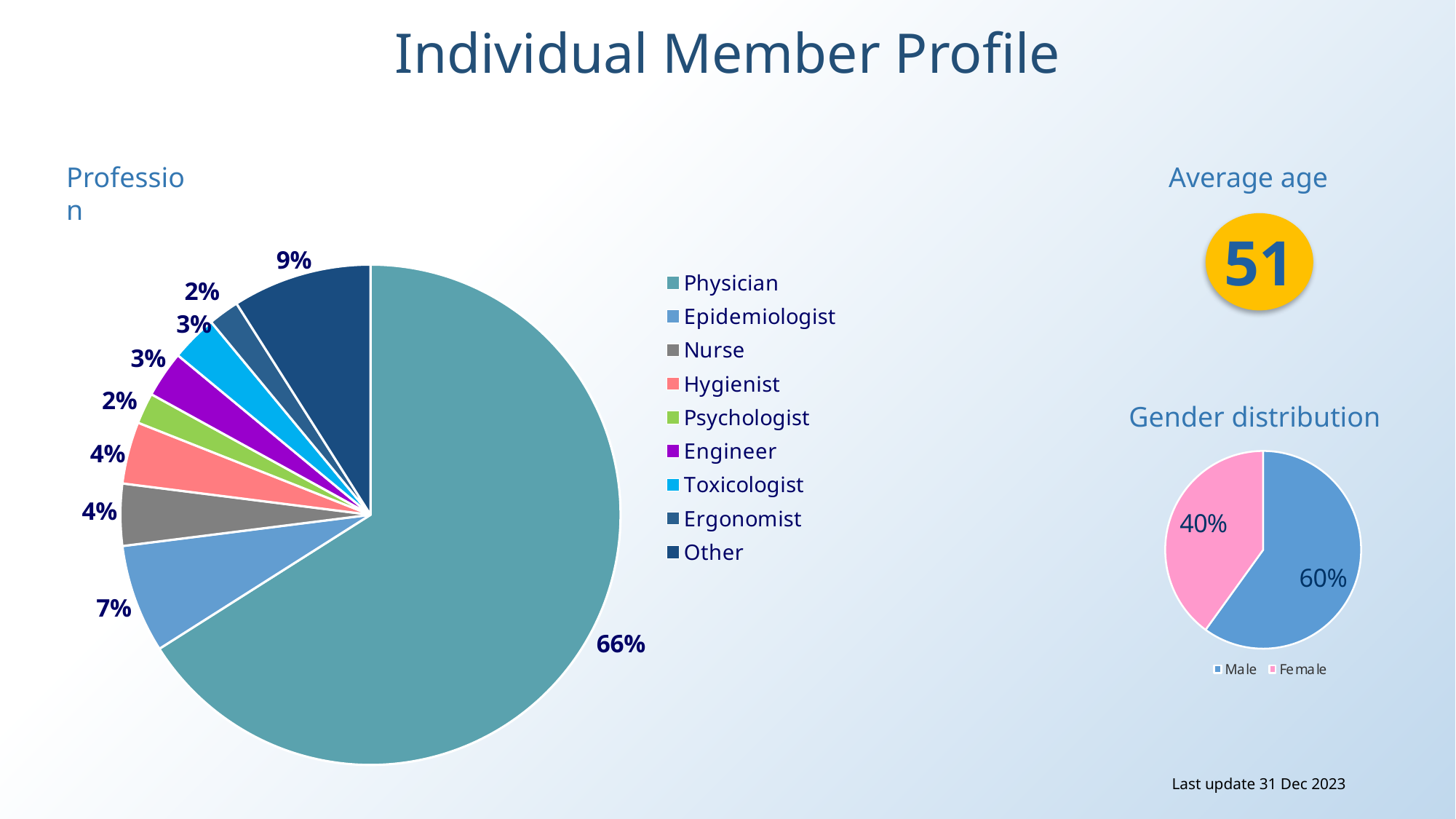
On the Profession chart, what is the difference in percentage points between the Physician share and the Other share? 57 On the Profession chart, which has the larger share, Epidemiologist or Nurse? Epidemiologist On the Gender distribution chart, what colour is the Female slice? Pink On the Profession chart, what share of members fall under Other? 9% On the Profession chart, how many profession categories does the legend list? 9 On the Gender distribution chart, what share of members are Male? 60% On the Profession chart, what share of members are Epidemiologists? 7% On the Gender distribution chart, what share of members are Female? 40% What kind of chart is the Profession chart? Pie chart On the Profession chart, what share of members are Physicians? 66% On the Gender distribution chart, which gender has the larger share? Male On the Profession chart, which profession has the largest share? Physician